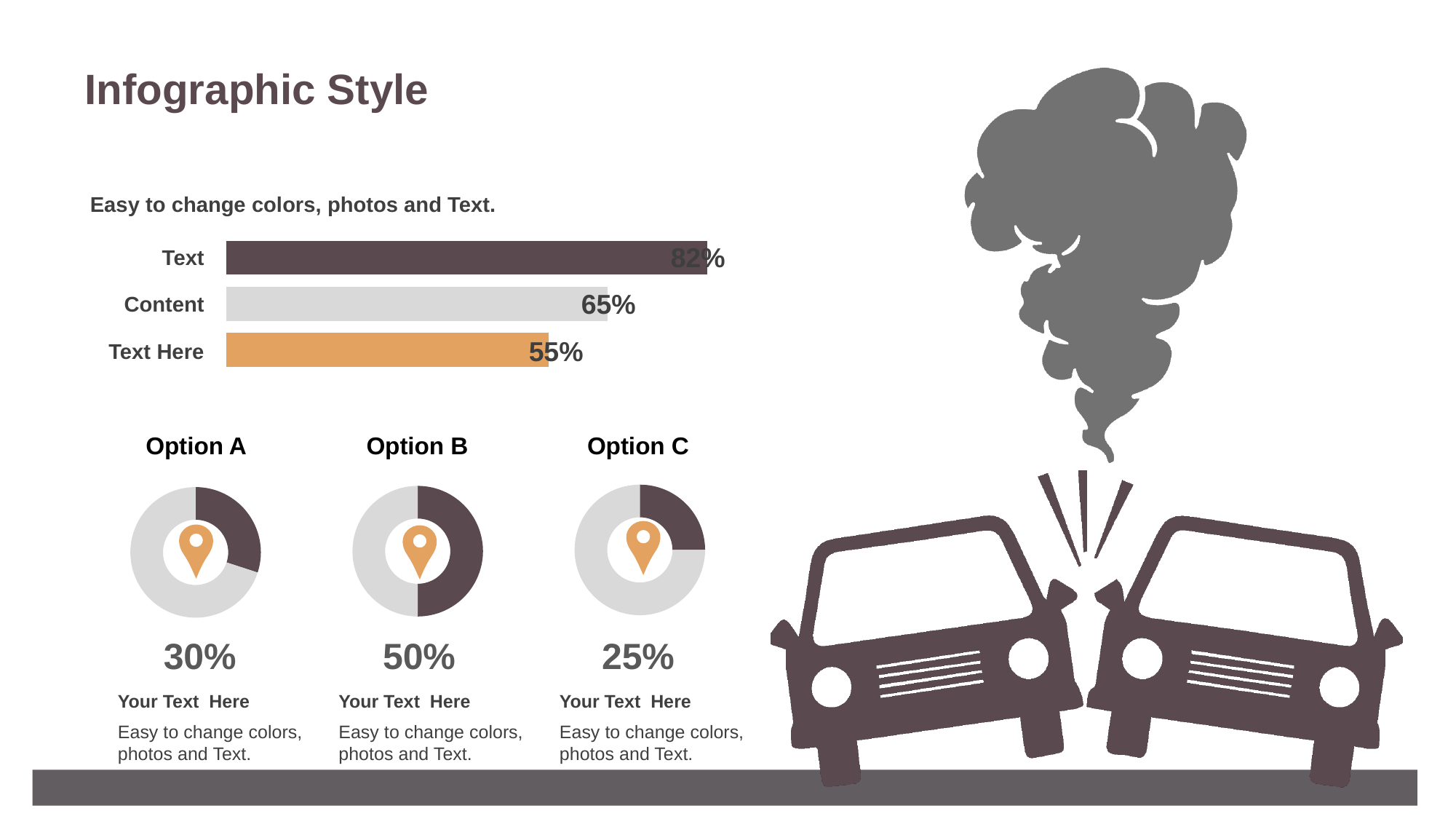
Which of the three donut charts (Option A, Option B, Option C) shows the lowest percentage? Option C In the horizontal bar chart, what is the value for Text Here? 55% What is the difference between the percentages shown for Option A and Option C? 5% In the horizontal bar chart, which category has the highest value? Text In the horizontal bar chart, which category has the lowest value? Text Here In the horizontal bar chart, what is the value for Content? 65% In the horizontal bar chart, which is larger, the value for Content or the value for Text Here? Content How many categories does the horizontal bar chart show? 3 In the horizontal bar chart, what is the value for Text? 82% In the donut chart for Option B, what percentage is shown? 50% In the horizontal bar chart, what is the difference between the values for Text and Content? 17% What kind of chart is the chart at the top left with the categories Text, Content and Text Here? Bar chart